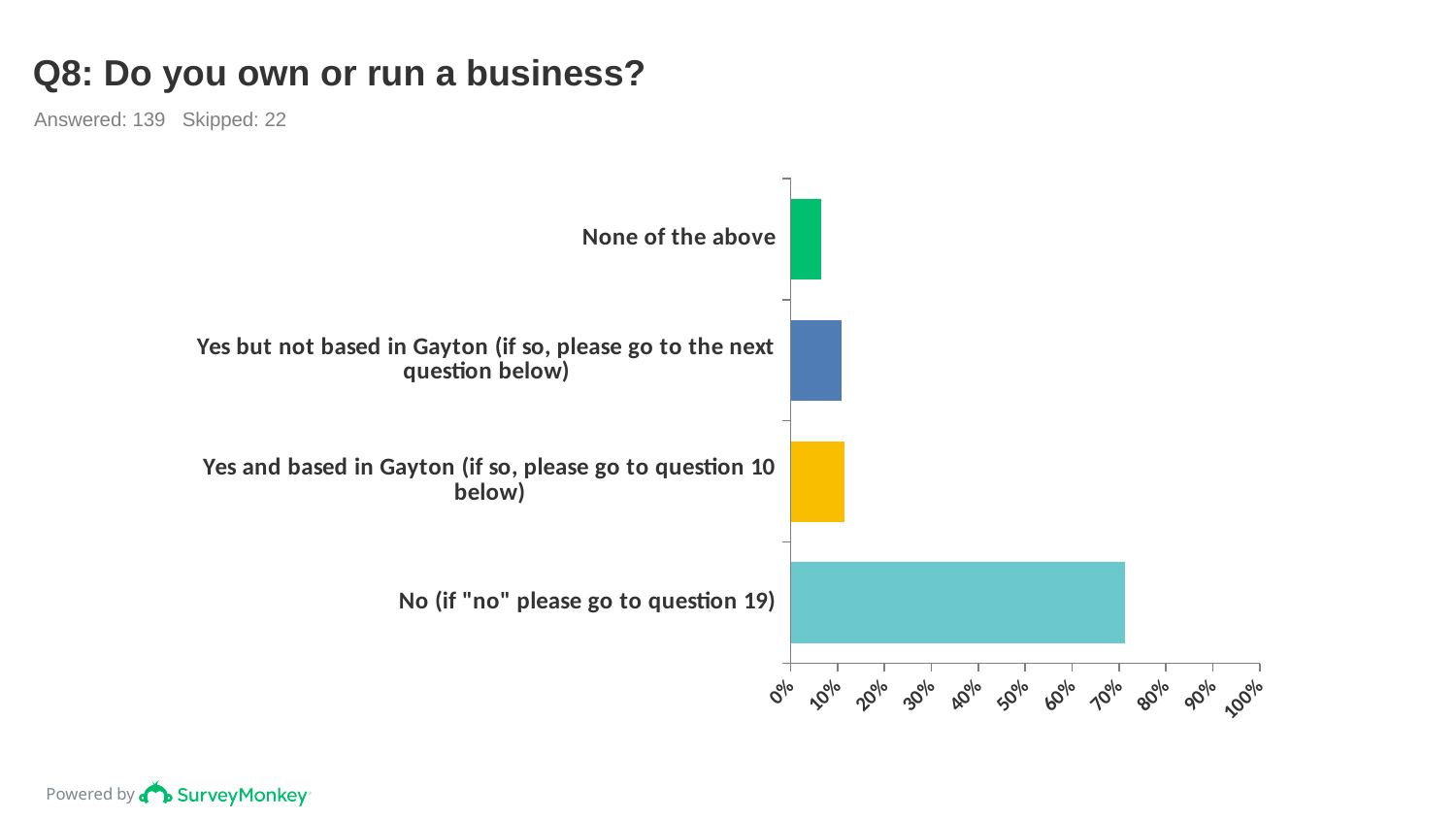
Is the value for "None of the above" greater or less than 10%? less Is the value for "No (if "no" please go to question 19)" greater or less than 60%? greater How many categories are plotted in the chart? 4 What is the title of the chart? Q8: Do you own or run a business? Which category has the highest value? No (if "no" please go to question 19) How many respondents answered the question according to the slide? 139 Is the value for "Yes but not based in Gayton (if so, please go to the next question below)" greater or less than 20%? less Which category has the lowest value? None of the above What kind of chart is shown on the slide? bar chart Which is larger: the value for "No (if "no" please go to question 19)" or the value for "None of the above"? No (if "no" please go to question 19)